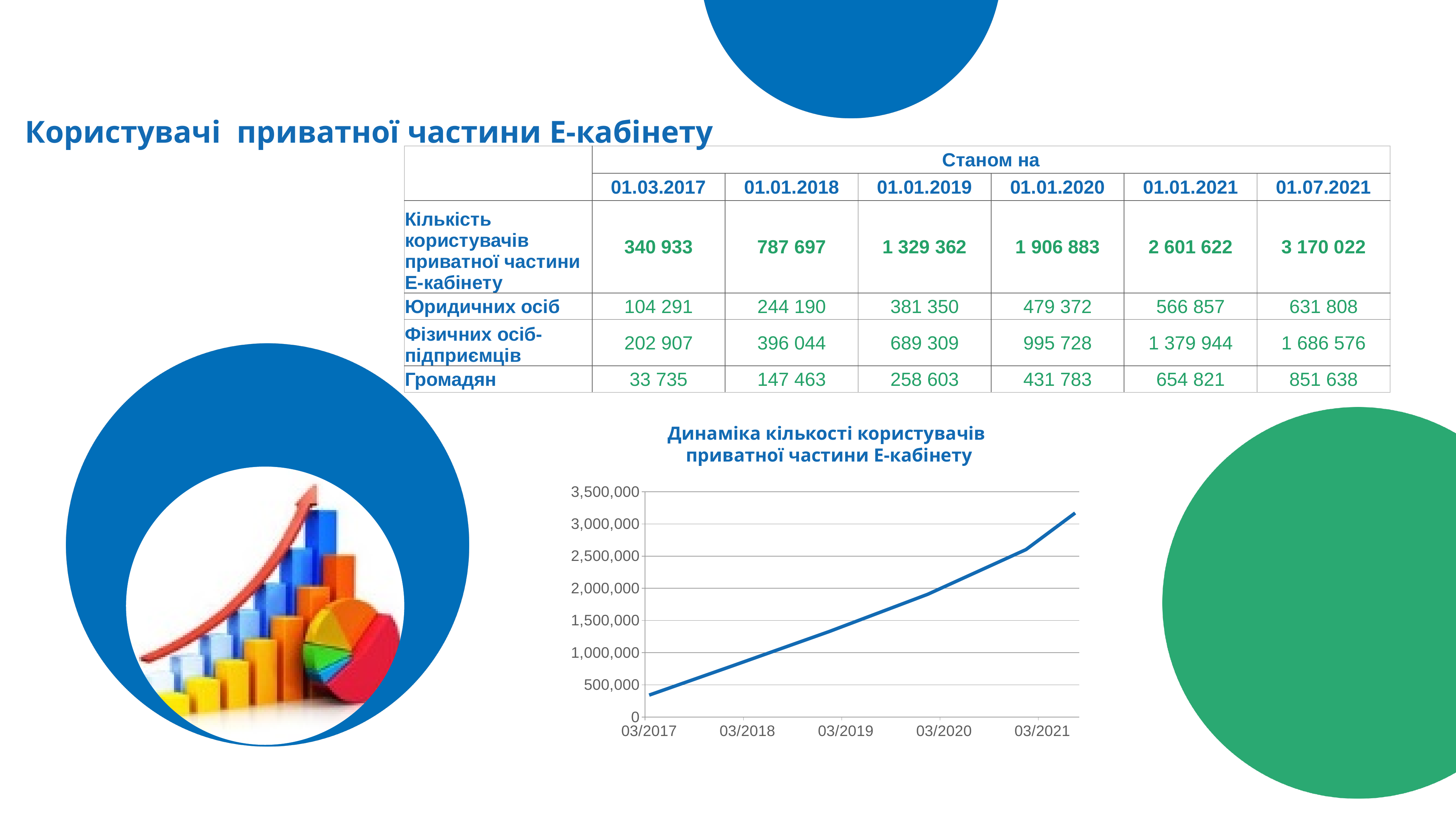
In the line chart, is the value at the last plotted point greater or less than 3,000,000? greater What is the title of the line chart on the slide? Динаміка кількості користувачів приватної частини Е-кабінету In the line chart, is the value at 03/2021 greater or less than 2,500,000? greater In the line chart, is the value at 03/2018 greater or less than 500,000? greater In the line chart, do the values rise or fall from 03/2017 to 03/2021? rise How many date labels are shown on the x axis of the line chart? 5 What is the highest value shown on the y axis of the line chart? 3,500,000 What kind of chart is shown under the title "Динаміка кількості користувачів приватної частини Е-кабінету"? line chart